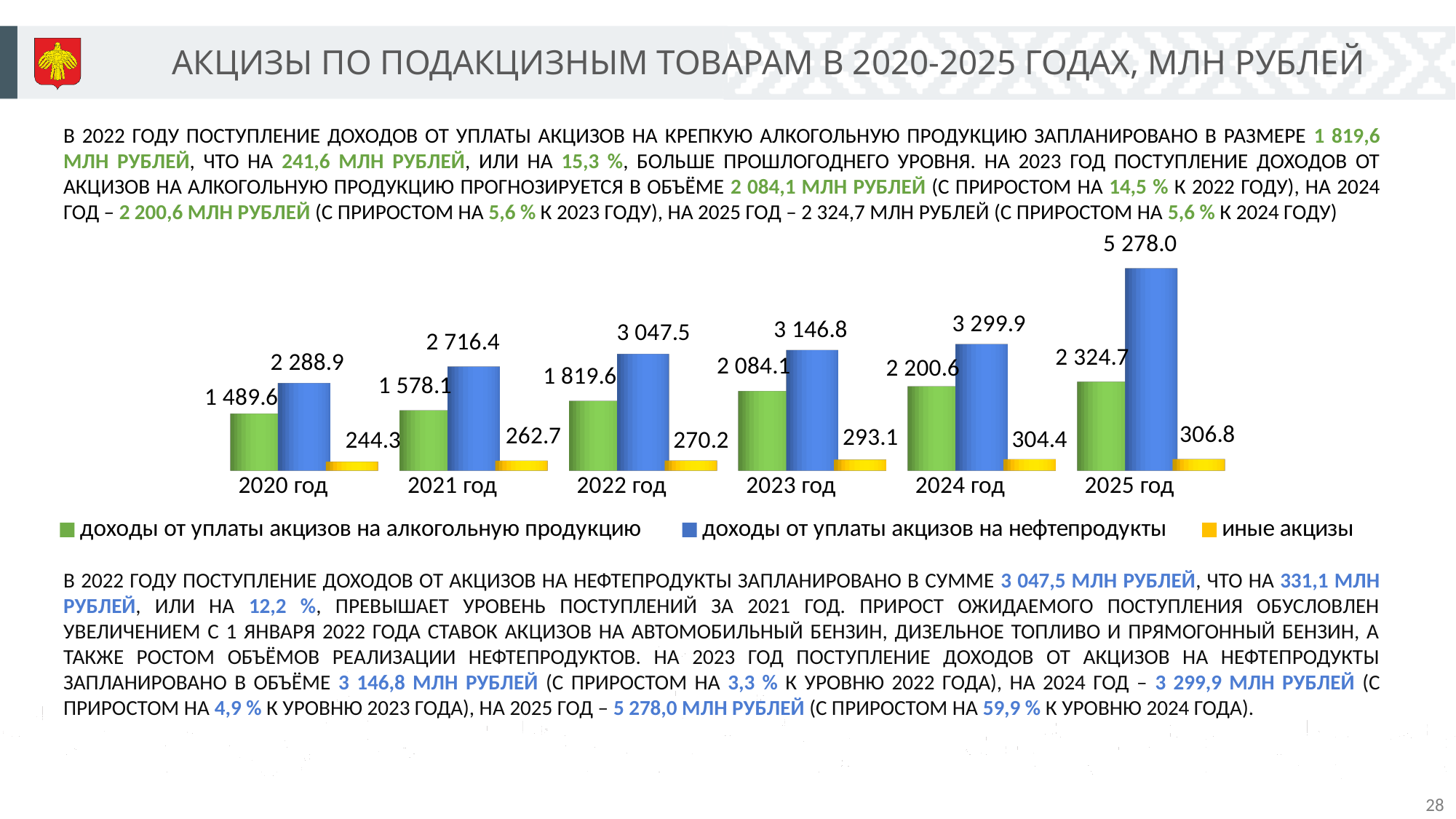
What colour represents иные акцизы in the chart? yellow Do the values of доходы от уплаты акцизов на алкогольную продукцию rise or fall from 2020 год to 2025 год? rise What is the value of доходы от уплаты акцизов на нефтепродукты for 2025 год? 5 278.0 What type of chart is shown on the slide? bar chart How many series does the legend list? 3 Which is larger in 2022 год: доходы от уплаты акцизов на алкогольную продукцию or доходы от уплаты акцизов на нефтепродукты? доходы от уплаты акцизов на нефтепродукты What is the value of иные акцизы for 2023 год? 293.1 How many years (categories) are shown on the x axis? 6 What is the value of доходы от уплаты акцизов на алкогольную продукцию for 2020 год? 1 489.6 What is the difference between доходы от уплаты акцизов на нефтепродукты in 2025 год and 2024 год? 1 978.1 In which year is the value of иные акцизы the lowest? 2020 год In which year is the value of доходы от уплаты акцизов на нефтепродукты the highest? 2025 год